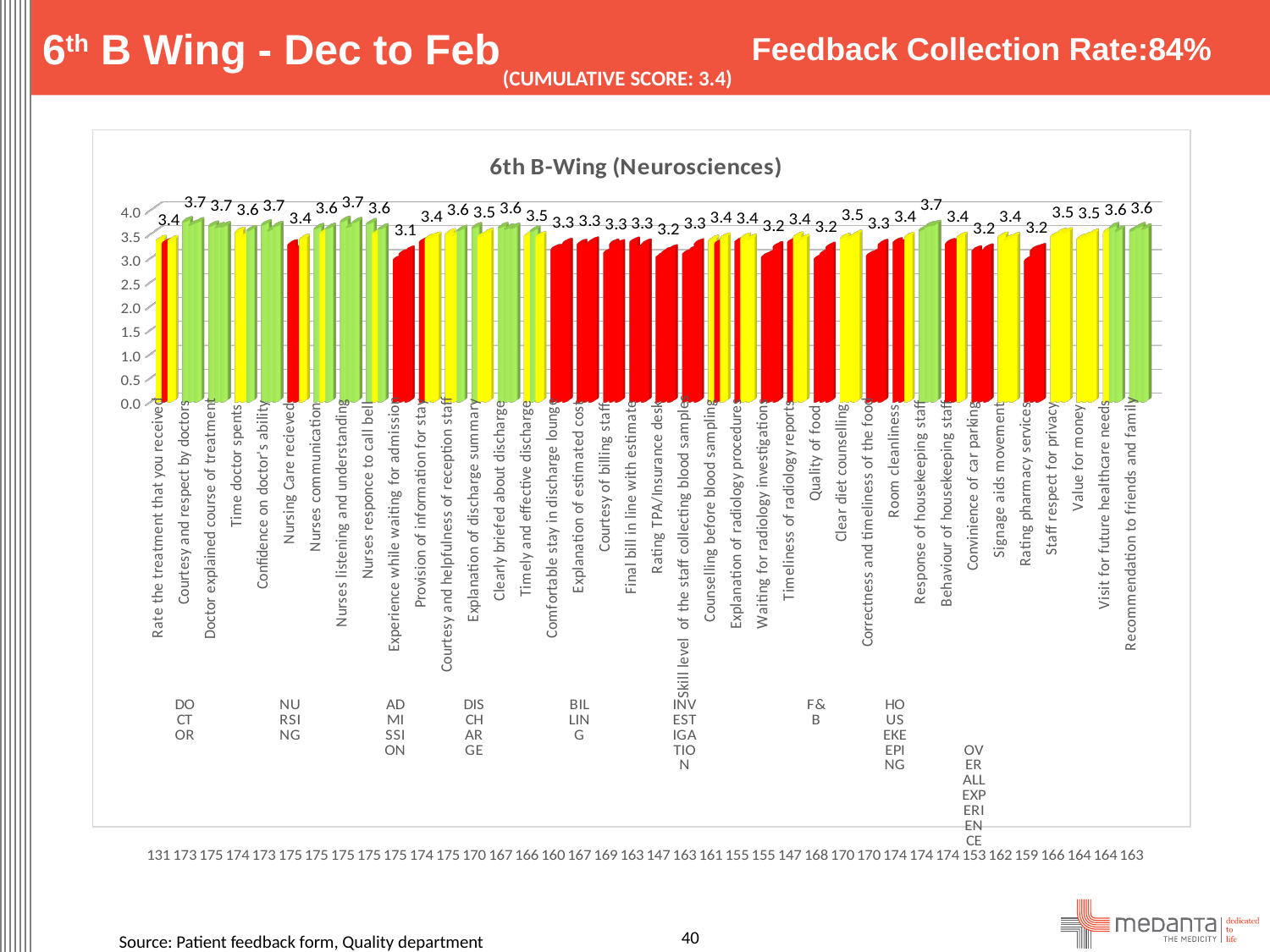
What is the highest value shown in the chart? 3.7 Which category has the lowest value in the chart? Experience while waiting for admission Which is larger, the value for 'Value for money' or the value for 'Convinience of car parking'? Value for money Is the value for 'Room cleanliness' greater or less than 3.0? greater What is the value for 'Quality of food'? 3.2 What is the value for 'Response of housekeeping staff'? 3.7 What is the value for 'Recommendation to friends and family'? 3.6 What is the value for 'Experience while waiting for admission'? 3.1 How many categories are plotted in the chart? 38 What is the difference between the values for 'Courtesy and respect by doctors' and 'Experience while waiting for admission'? 0.6 What kind of chart is shown on the slide? bar chart What is the title of the chart? 6th B-Wing (Neurosciences)